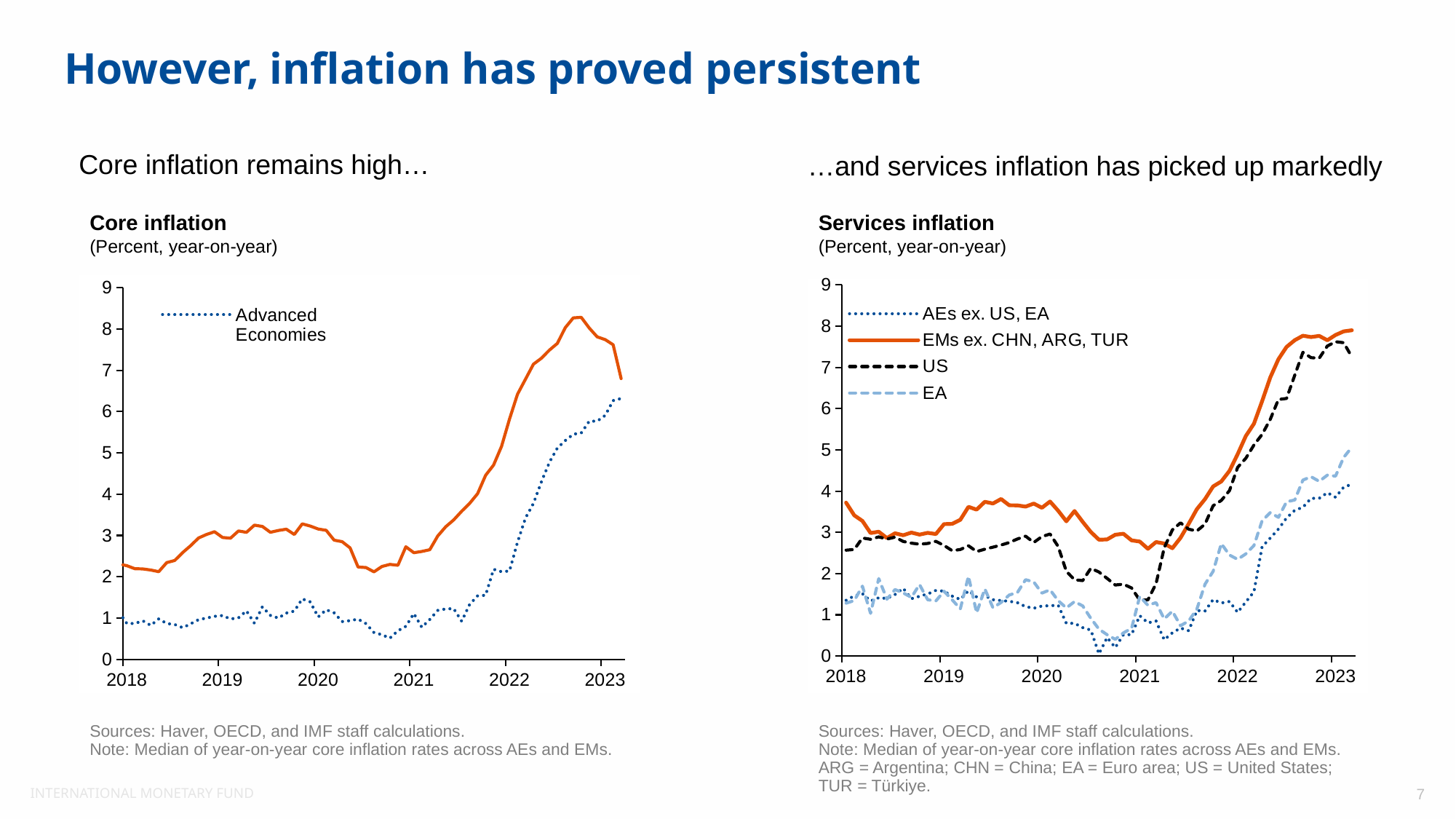
In the "Core inflation" chart, does the Advanced Economies line rise or fall between 2021 and 2023? rise In the "Services inflation" chart, is the value for EA at the start of 2018 greater or less than 2? less What unit is shown under the title of the "Services inflation" chart? Percent, year-on-year How many series does the legend of the "Services inflation" chart list? 4 In the "Services inflation" chart, is the value for US at the start of 2023 greater or less than 7? greater In the "Services inflation" chart, which series is higher at the start of 2023: EA or AEs ex. US, EA? EA In the "Services inflation" chart, is the value for AEs ex. US, EA at the start of 2023 greater or less than 3? greater What kind of chart is the "Core inflation" chart? line chart In the "Services inflation" chart, does the US line rise or fall between 2021 and 2023? rise What is the highest value shown on the y axis of the "Core inflation" chart? 9